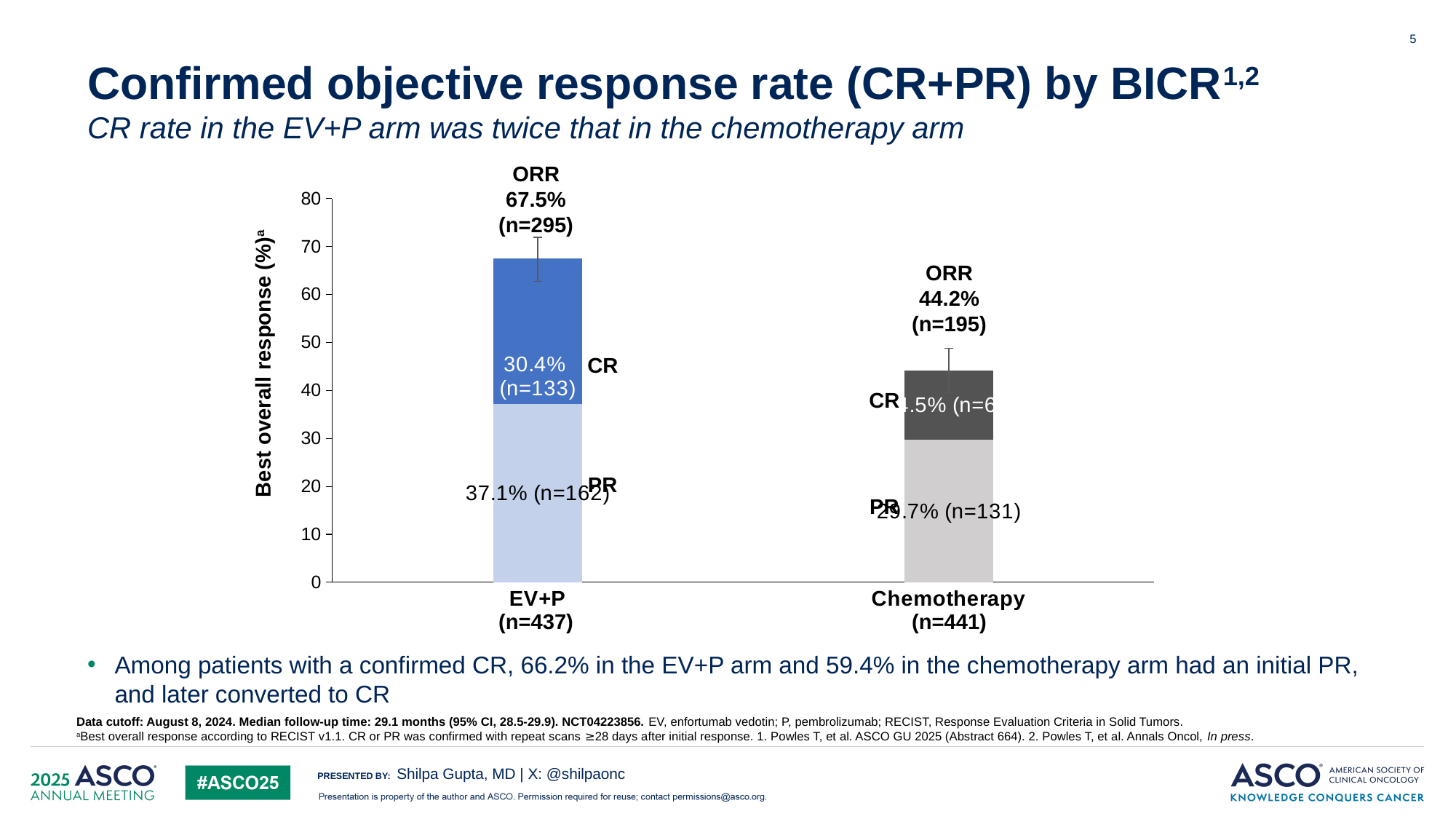
What is the PR rate in the Chemotherapy arm? 29.7% What is the difference in ORR between the EV+P arm and the Chemotherapy arm? 23.3 percentage points What is the PR rate in the EV+P arm? 37.1% What is the ORR for the Chemotherapy arm? 44.2% What is the label of the y-axis? Best overall response (%) What is the CR rate in the EV+P arm? 30.4% How many patients had a confirmed objective response in the Chemotherapy arm? n=195 What kind of chart is shown on the slide? Stacked bar chart Which arm has the higher PR rate, EV+P or Chemotherapy? EV+P Which arm has the higher ORR? EV+P What is the ORR for the EV+P arm? 67.5% How many treatment arms (bars) are plotted in the chart? 2